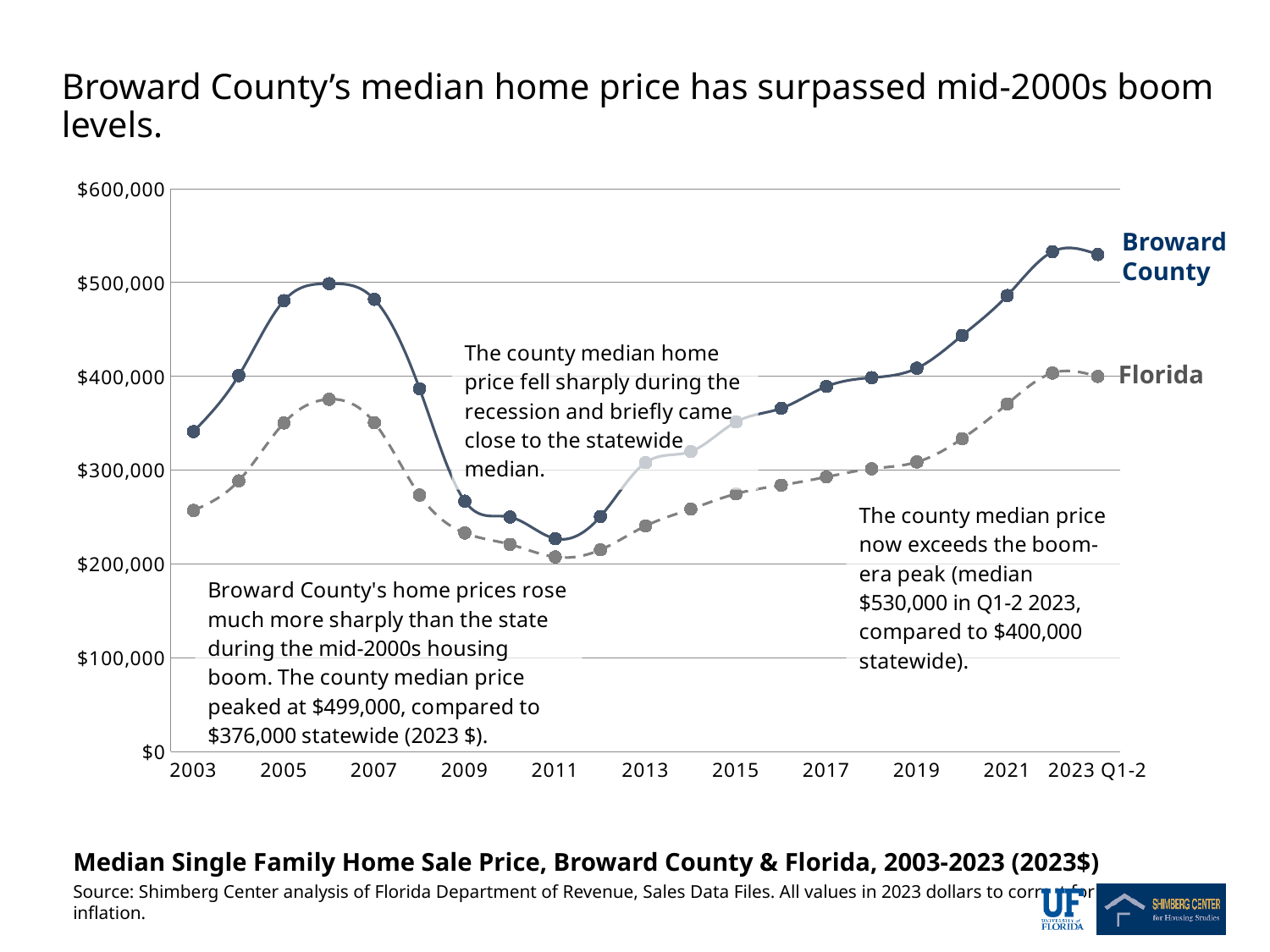
In which year was the Broward County median home price at its lowest? 2011 What is the difference between the Broward County and Florida medians in Q1-2 2023? $130,000 Which two series are plotted on the chart? Broward County and Florida Is the Broward County value for 2003 greater or less than $300,000? greater What kind of chart is shown on the slide? line chart Which series has the higher value in 2003, Broward County or Florida? Broward County Is the Florida value for 2011 greater or less than $300,000? less According to the slide, what was the statewide median home price at the mid-2000s peak (2023 $)? $376,000 According to the slide, what was Broward County's peak median home price during the mid-2000s boom (2023 $)? $499,000 How many series are plotted on the chart? 2 What was Broward County's median home price in Q1-2 2023? $530,000 What was the Florida statewide median home price in Q1-2 2023? $400,000